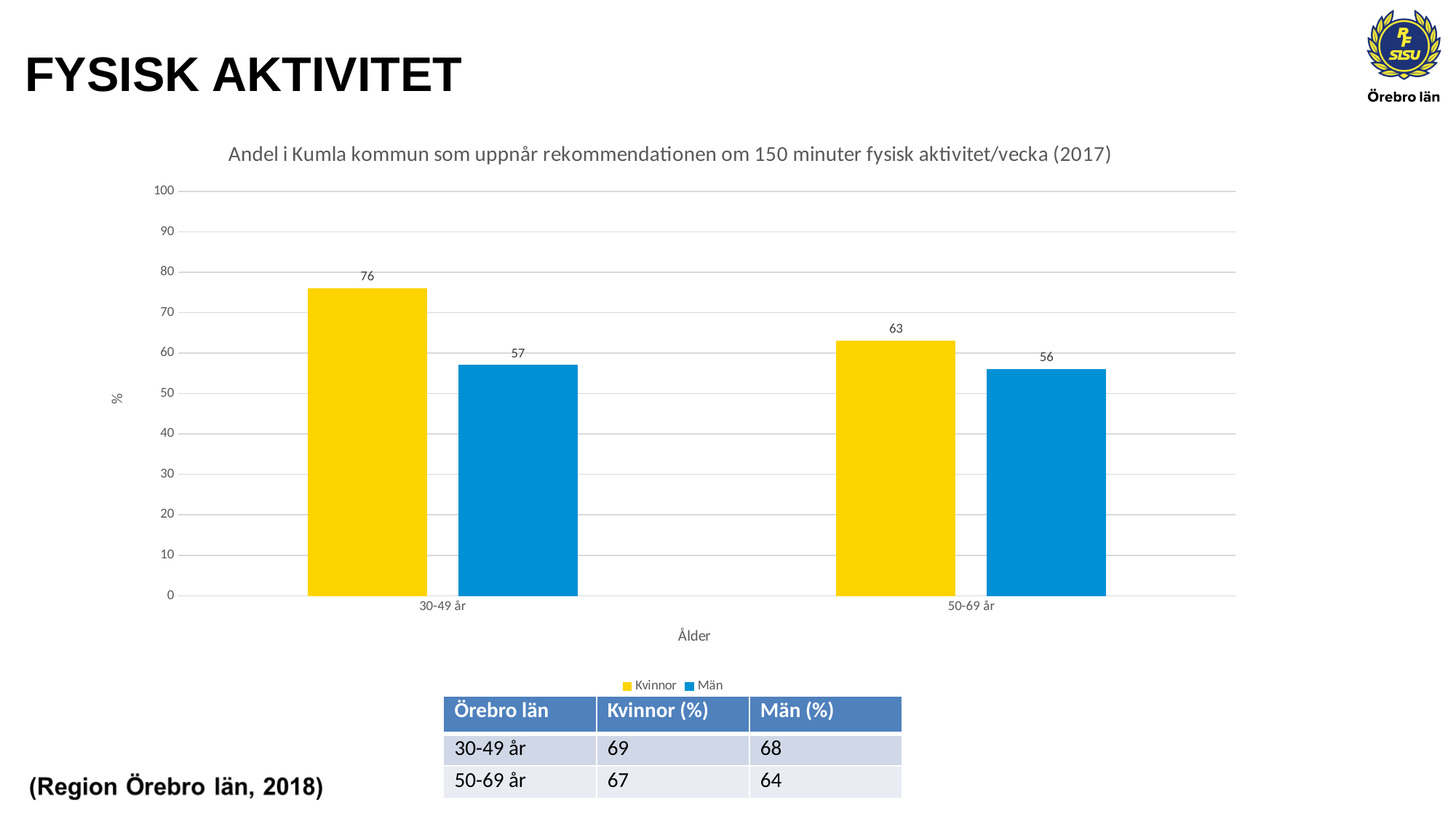
How many series does the legend list? 2 Which bar has the lowest value on the chart? Män, 50-69 år What is the value for Män in the 50-69 år age group? 56 What is the value for Kvinnor in the 50-69 år age group? 63 Which bar has the highest value on the chart? Kvinnor, 30-49 år What is the value for Kvinnor in the 30-49 år age group? 76 What is the label of the x axis? Ålder What is the difference between Kvinnor and Män in the 30-49 år age group? 19 What kind of chart is shown on the slide? Bar chart Which is larger: Kvinnor for 50-69 år or Män for 30-49 år? Kvinnor for 50-69 år What is the difference between the Kvinnor values for 30-49 år and 50-69 år? 13 How many age groups are shown on the x axis? 2